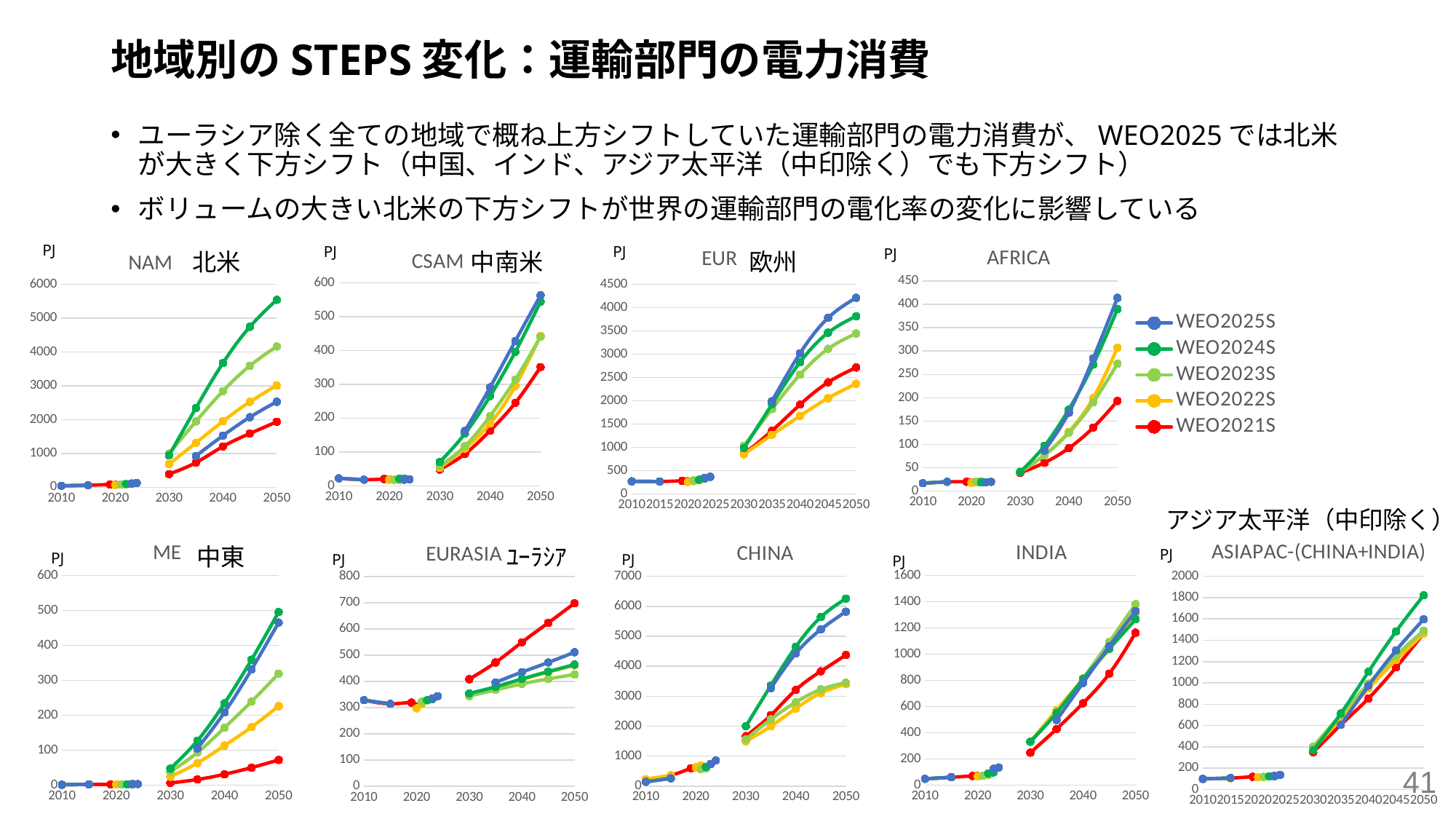
How many series does the legend list? 5 What kind of chart is the NAM (北米) chart? line chart In the EURASIA (ユーラシア) chart, which series has the highest value in 2050? WEO2021S In the INDIA chart, which series has the lowest value in 2050? WEO2021S In the CHINA chart, which is larger in 2050, WEO2024S or WEO2021S? WEO2024S In the NAM (北米) chart, is the WEO2025S value in 2050 greater or less than 3000? less How many regional charts are shown on the slide? 9 In the NAM (北米) chart, which series has the lowest value in 2050? WEO2021S In the NAM (北米) chart, which series has the highest value in 2050? WEO2024S What unit is shown on the vertical axis of the charts? PJ In the EUR (欧州) chart, is the WEO2025S value in 2050 greater or less than 4000? greater In the EURASIA (ユーラシア) chart, does the WEO2021S series rise or fall from 2030 to 2050? rise